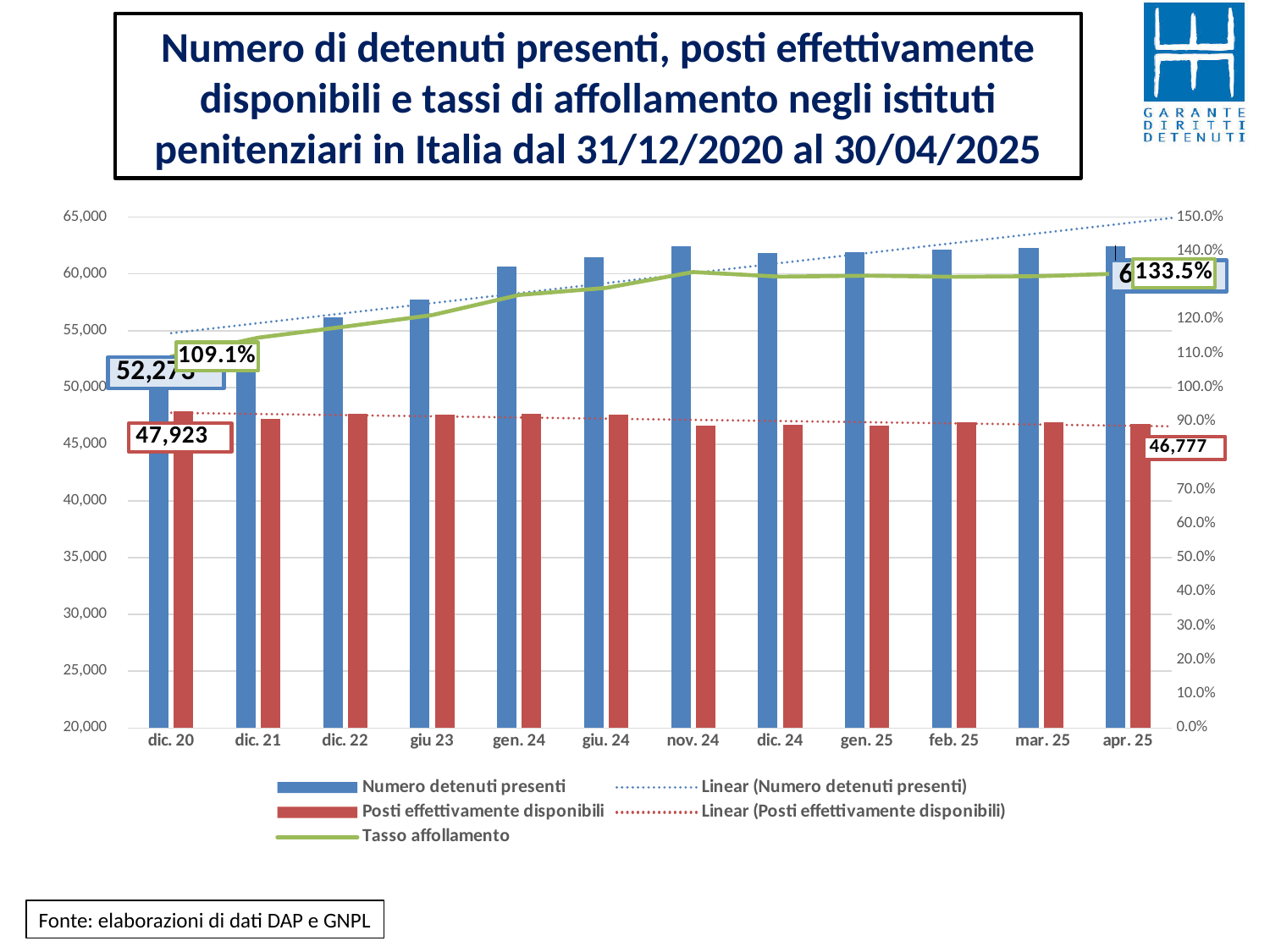
Which period has the lowest value of Numero detenuti presenti? dic. 20 How many time periods are shown on the x axis? 12 By how many percentage points did the Tasso affollamento rise from dic. 20 to apr. 25? 24.4 percentage points What is the Tasso affollamento for apr. 25? 133.5% What is the value of Posti effettivamente disponibili for dic. 20? 47,923 What is the value of Posti effettivamente disponibili for apr. 25? 46,777 What is the Tasso affollamento for dic. 20? 109.1% Is the value of Numero detenuti presenti for apr. 25 greater or less than 60,000? greater Does the Numero detenuti presenti generally rise or fall from dic. 20 to apr. 25? rise By how much did Posti effettivamente disponibili decrease from dic. 20 to apr. 25? 1,146 Which period has the higher value of Posti effettivamente disponibili, dic. 20 or apr. 25? dic. 20 How many entries does the legend list? 5